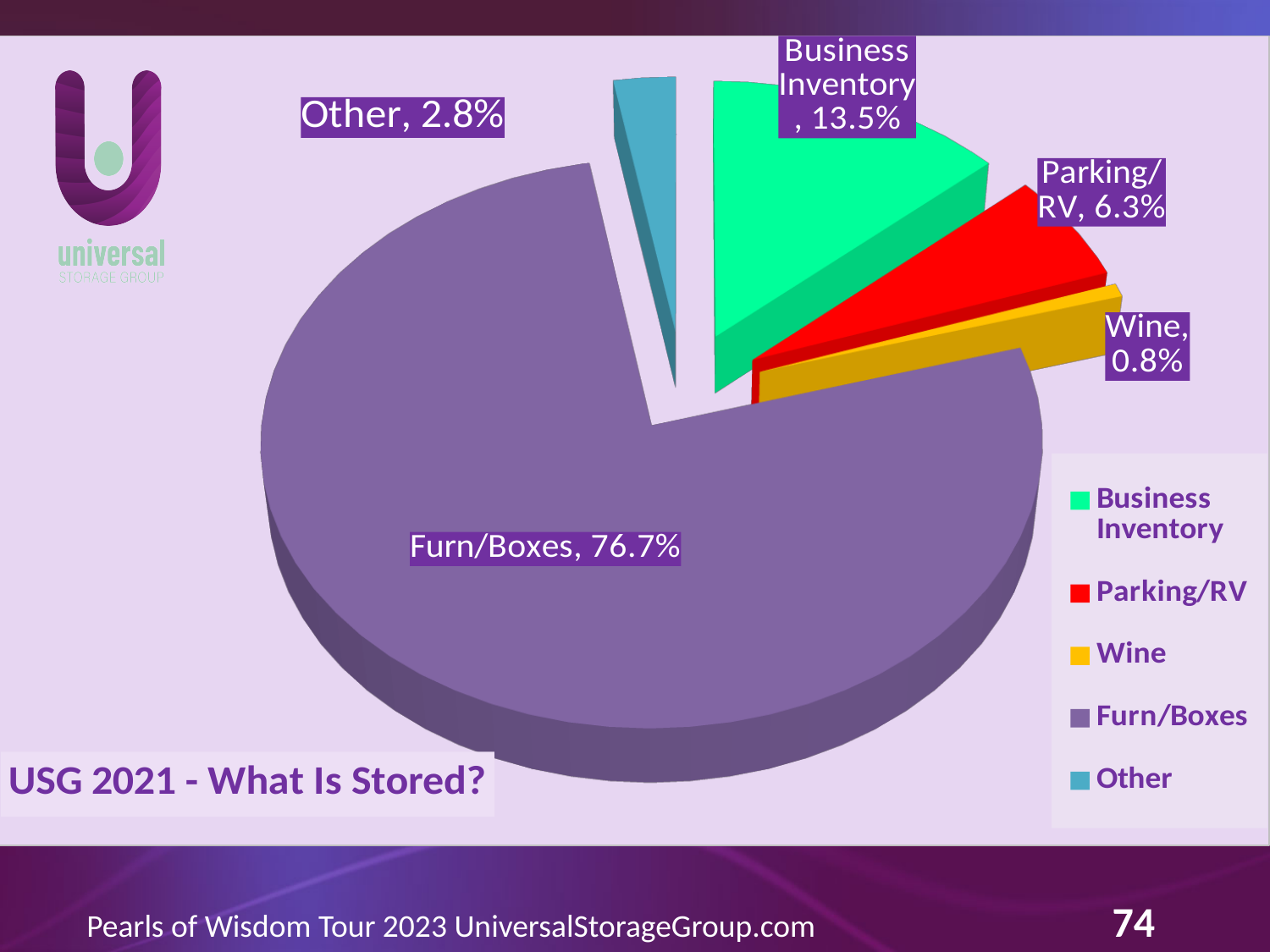
What share of the pie is Wine? 0.8% How many categories does the pie chart show? 5 What share of the pie is Parking/RV? 6.3% What kind of chart is shown on the slide? Pie chart Which is larger, the share for Other or the share for Wine? Other Which category has the largest slice of the pie? Furn/Boxes Which category has the smallest slice of the pie? Wine What is the difference in percentage points between Business Inventory and Parking/RV? 7.2 What is the title of the chart? USG 2021 - What Is Stored? What share of the pie is Business Inventory? 13.5% What share of the pie is Furn/Boxes? 76.7% What share of the pie is Other? 2.8%